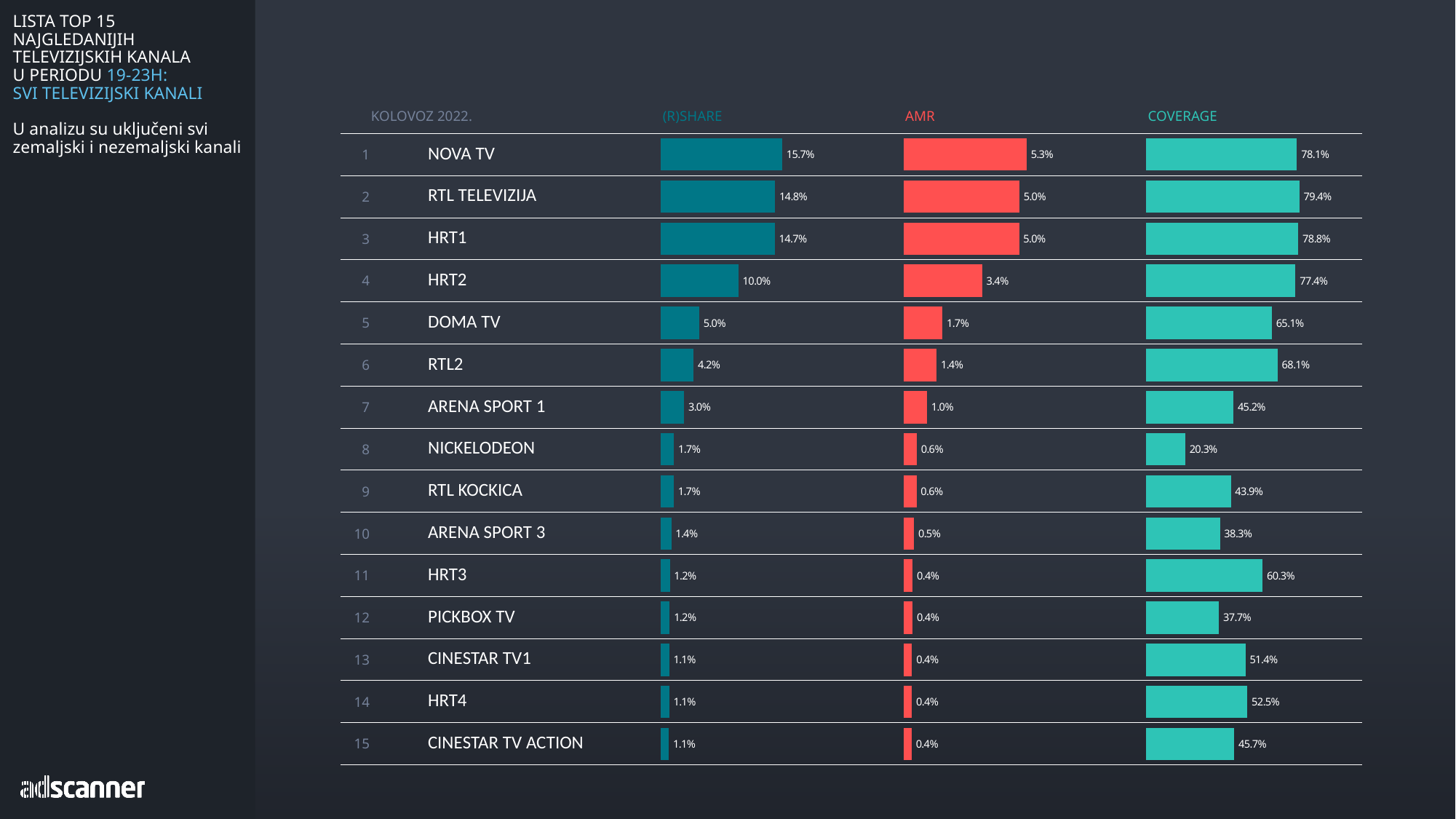
What kind of chart is used to show the (R)SHARE, AMR and COVERAGE values? Bar chart Which has the larger COVERAGE value, RTL2 or ARENA SPORT 1? RTL2 Which month and year does the chart cover, as shown in the header? KOLOVOZ 2022. What is the COVERAGE value for DOMA TV? 65.1% How many channels are listed in the chart? 15 What is the (R)SHARE value for NOVA TV? 15.7% What is the COVERAGE value for HRT3? 60.3% Which channel has the highest (R)SHARE value? NOVA TV What is the difference in (R)SHARE between NOVA TV and RTL TELEVIZIJA? 0.9% Which channel has the highest COVERAGE value? RTL TELEVIZIJA Which channel has the lowest COVERAGE value? NICKELODEON What is the AMR value for HRT2? 3.4%